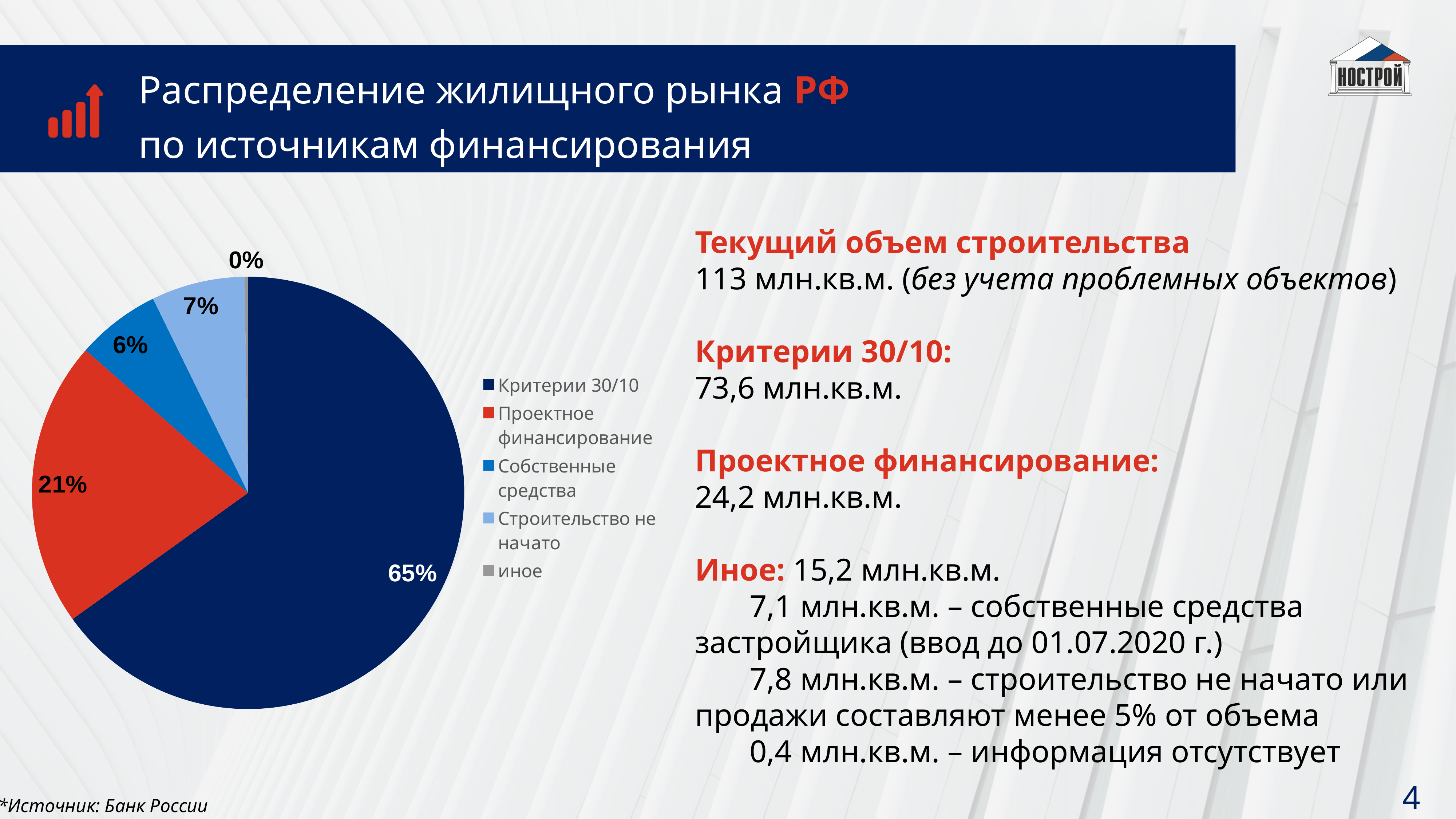
How many categories does the pie chart legend list? 5 What share of the pie chart does "иное" have? 0% What colour is the "Проектное финансирование" slice in the pie chart? red Which category has the smallest slice of the pie chart? иное What share of the pie chart does "Проектное финансирование" have? 21% Which slice is larger: "Собственные средства" or "Строительство не начато"? Строительство не начато What share of the pie chart does "Строительство не начато" have? 7% What share of the pie chart does "Собственные средства" have? 6% What share of the pie chart does "Критерии 30/10" have? 65% What is the difference in percentage points between the "Критерии 30/10" slice and the "Проектное финансирование" slice? 44 Which category has the largest slice of the pie chart? Критерии 30/10 What type of chart is shown on the slide? pie chart